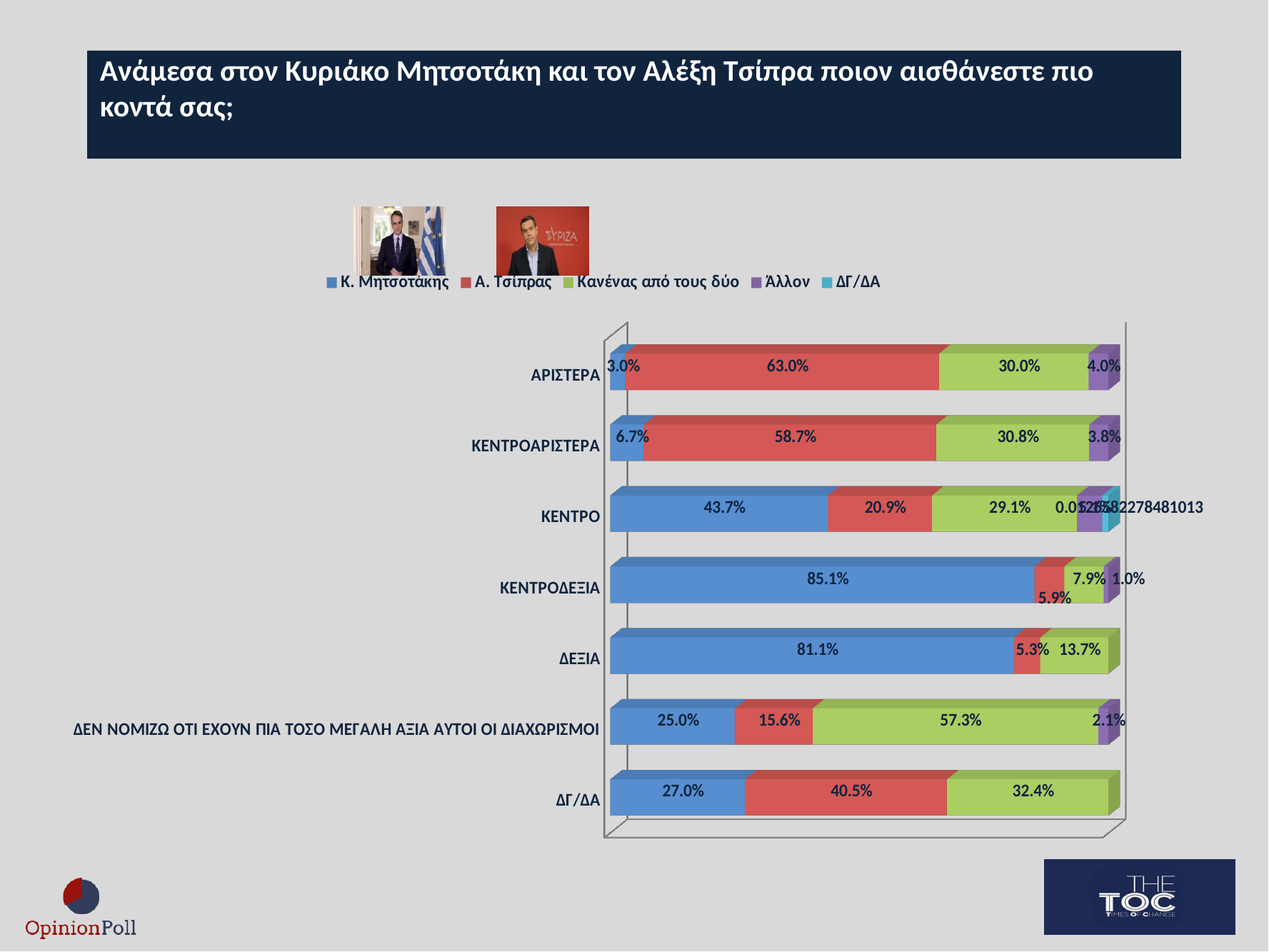
What is the total of the stacked bar for ΔΓ/ΔΑ? 99.9% What is the value for Κανένας από τους δύο in the ΔΕΝ ΝΟΜΙΖΩ ΟΤΙ ΕΧΟΥΝ ΠΙΑ ΤΟΣΟ ΜΕΓΑΛΗ ΑΞΙΑ ΑΥΤΟΙ ΟΙ ΔΙΑΧΩΡΙΣΜΟΙ category? 57.3% How many series does the chart legend list? 5 In which category does Κ. Μητσοτάκης have the lowest value? ΑΡΙΣΤΕΡΑ How many categories are plotted on the chart? 7 Which colour represents Α. Τσίπρας in the chart? Red In which category does Κ. Μητσοτάκης have the highest value? ΚΕΝΤΡΟΔΕΞΙΑ In the ΔΓ/ΔΑ category, which is larger: the value for Κ. Μητσοτάκης or for Α. Τσίπρας? Α. Τσίπρας What kind of chart is shown on the slide? Stacked bar chart What is the value for Κ. Μητσοτάκης in the ΚΕΝΤΡΟΔΕΞΙΑ category? 85.1% What is the value for Α. Τσίπρας in the ΑΡΙΣΤΕΡΑ category? 63.0% In the ΔΕΞΙΑ category, what is the difference between the value for Κ. Μητσοτάκης and the value for Α. Τσίπρας? 75.8 percentage points